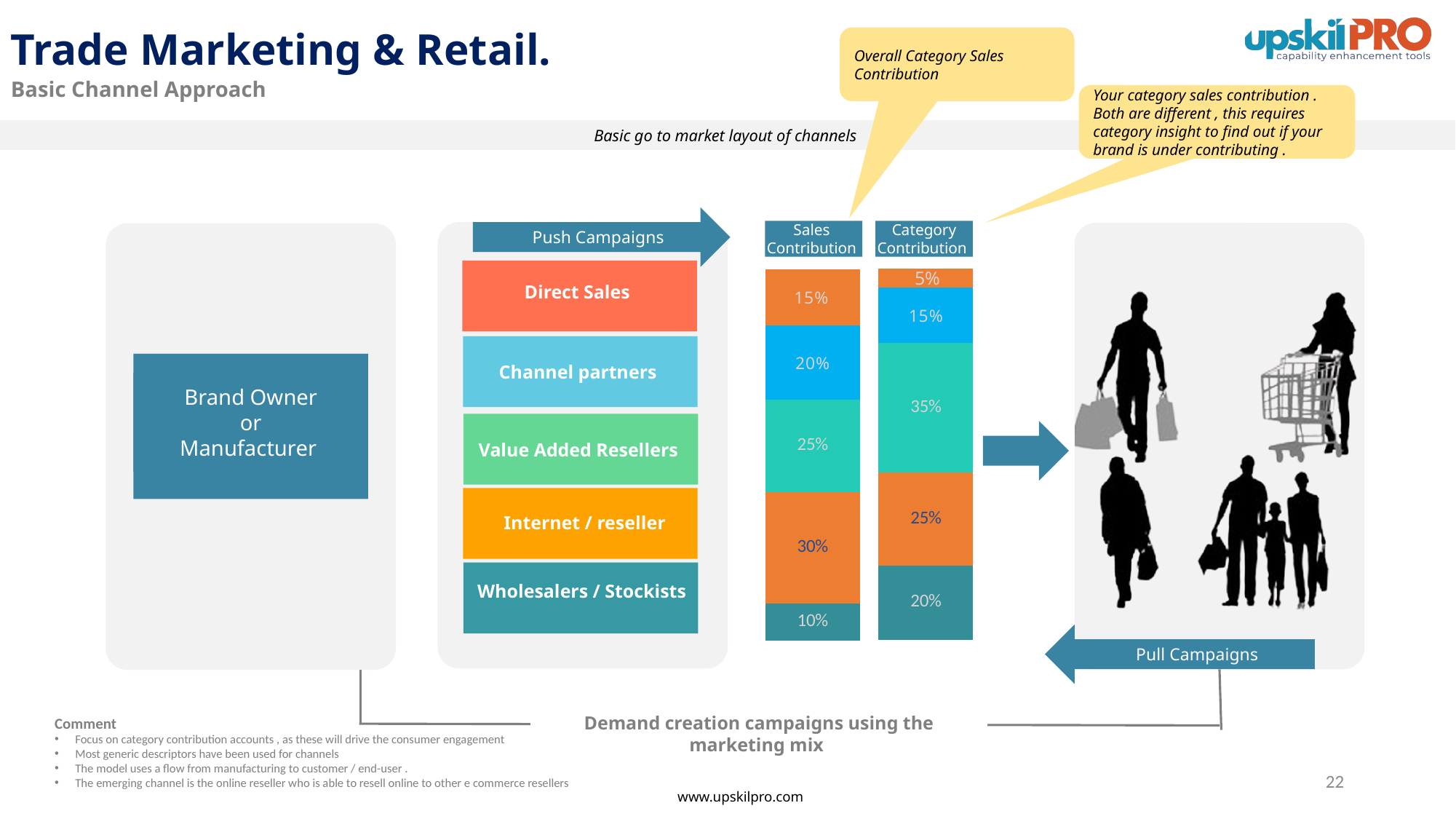
In the Category Contribution bar, what is the value of the top segment (aligned with Direct Sales)? 5% What is the difference between the Sales Contribution and Category Contribution values for the segment aligned with Value Added Resellers? 10% In the Sales Contribution bar, what is the value of the bottom segment (aligned with Wholesalers / Stockists)? 10% In the Sales Contribution bar, what is the value of the top segment (aligned with Direct Sales)? 15% In the Category Contribution bar, what is the value of the middle segment (aligned with Value Added Resellers)? 35% How many segments does each stacked bar contain? 5 In the Category Contribution bar, what is the value of the bottom segment (aligned with Wholesalers / Stockists)? 20% What kind of chart is used to show Sales Contribution and Category Contribution? Stacked bar chart Which segment of the Category Contribution bar has the smallest value? 5% (the segment aligned with Direct Sales) Which segment of the Sales Contribution bar has the largest value? 30% (the segment aligned with Internet / reseller) For the segment aligned with Internet / reseller, which is larger: the Sales Contribution value or the Category Contribution value? Sales Contribution (30%) What is the total of the segments in the Sales Contribution bar? 100%